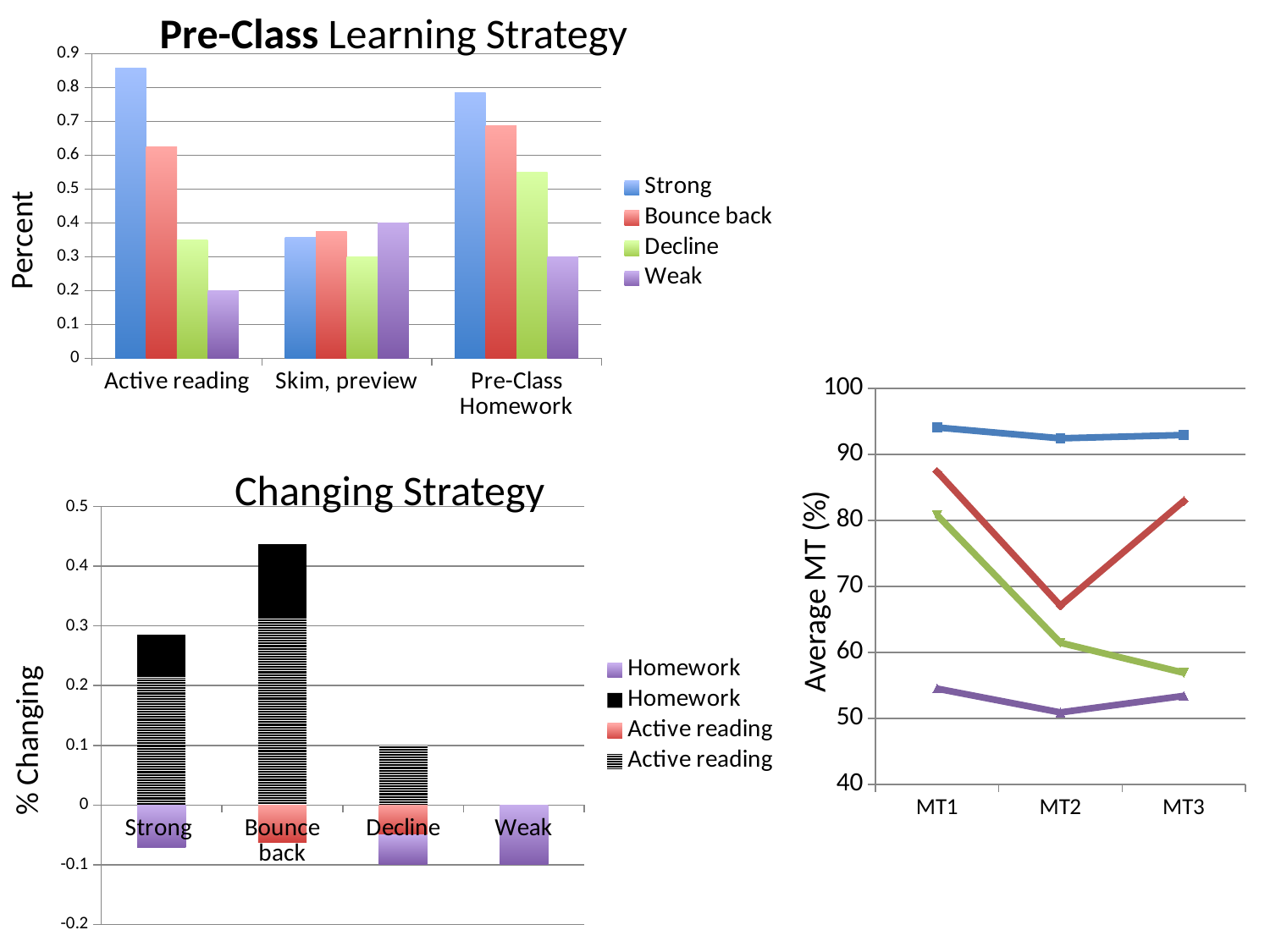
In the "Pre-Class Learning Strategy" chart, which series has the highest value for Active reading? Strong In the "Changing Strategy" chart, is the top of the stacked bar for Bounce back greater or less than 0.4? greater How many series does the legend of the "Pre-Class Learning Strategy" chart list? 4 In the "Pre-Class Learning Strategy" chart, is the Strong value for Active reading greater or less than 0.8? greater In the "Changing Strategy" chart, which category has the tallest positive stacked bar? Bounce back What type of chart is the "Pre-Class Learning Strategy" chart? bar chart In the "Pre-Class Learning Strategy" chart, which series has the lowest value for Active reading? Weak What type of chart is the chart on the right of the slide with the y axis "Average MT (%)"? line chart In the line chart on the right, how many points are plotted on the x axis? 3 How many categories are shown on the x axis of the "Changing Strategy" chart? 4 In the "Pre-Class Learning Strategy" chart, which is larger for Skim, preview: Weak or Decline? Weak In the line chart on the right, does the green line rise or fall from MT1 to MT3? fall